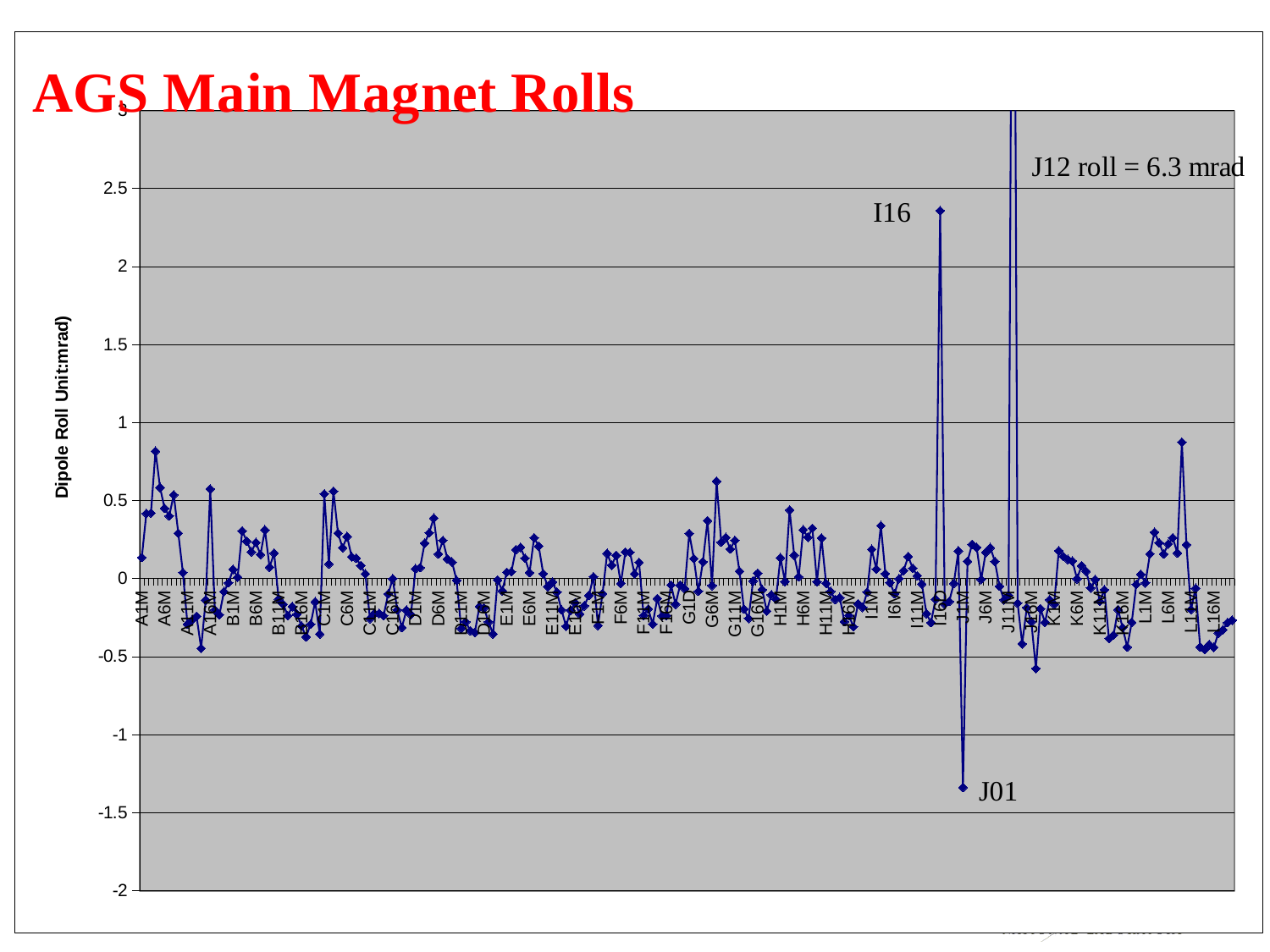
According to the annotation on the chart, what is the roll of magnet J12? 6.3 mrad What is the title of the chart? AGS Main Magnet Rolls Which magnet has the largest roll value on the chart? J12 Which has the larger roll value, I16 or J01? I16 Is the roll value for J01 greater or less than -1? less What is the highest value shown on the vertical axis? 3 What is the label on the vertical axis of the chart? Dipole Roll Unit:mrad) Is the roll value for I16 greater or less than 2? greater Which labeled magnet has the lowest (most negative) roll value on the chart? J01 What kind of chart is shown on the slide? line chart Is the roll value for I16 greater or less than 2.5? less